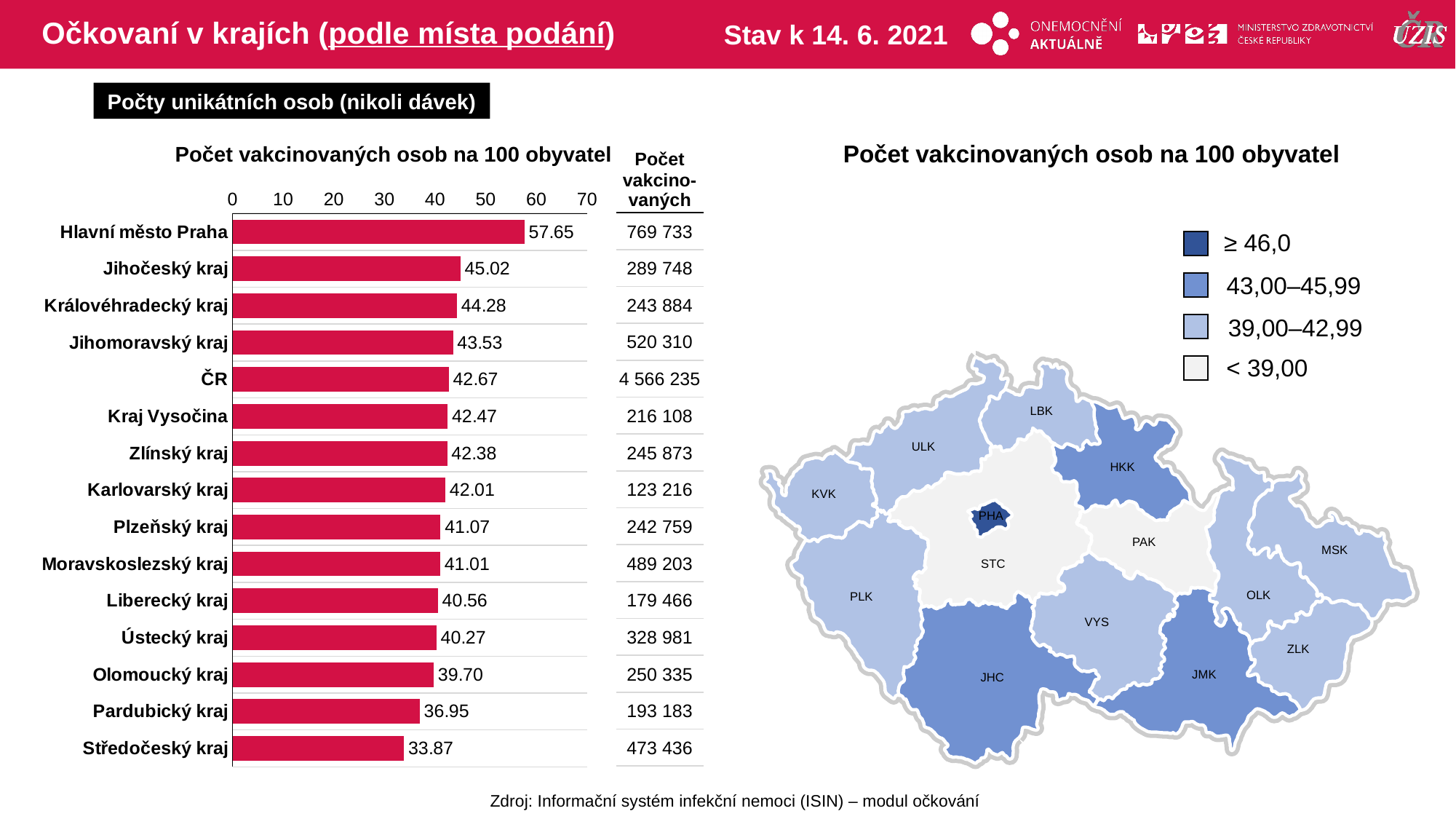
What type of chart is used on the left side of the slide to show vaccinated persons per 100 inhabitants? bar chart In the bar chart, what is the number of vaccinated persons per 100 inhabitants for Hlavní město Praha? 57.65 In the bar chart, what is the difference between the values for Hlavní město Praha and Středočeský kraj? 23.78 In the bar chart, what is the value for ČR? 42.67 In the bar chart, which region has the lowest number of vaccinated persons per 100 inhabitants? Středočeský kraj How many categories (bars) are shown in the bar chart? 15 In the bar chart, which region has the highest number of vaccinated persons per 100 inhabitants? Hlavní město Praha In the bar chart, which has a higher value, Jihočeský kraj or Pardubický kraj? Jihočeský kraj In the bar chart, is the value for Olomoucký kraj greater or less than 40? less What is the title of the bar chart on the left of the slide? Počet vakcinovaných osob na 100 obyvatel In the bar chart, what is the difference between the values for Jihočeský kraj and Královéhradecký kraj? 0.74 In the bar chart, what is the value for Jihomoravský kraj? 43.53